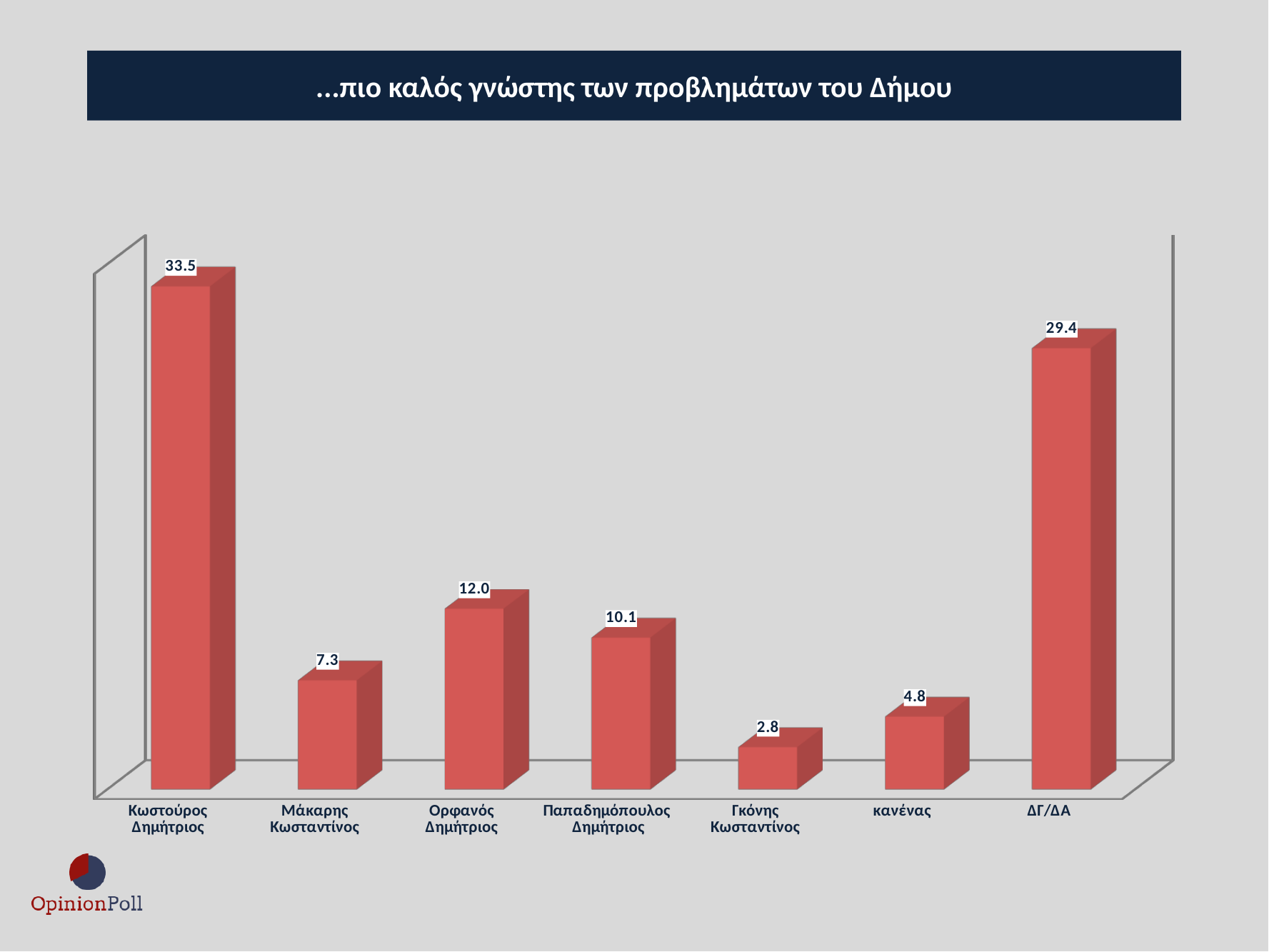
What is the value for Κωστούρος Δημήτριος? 33.5 What kind of chart is this? bar chart What is the title of the chart? ...πιο καλός γνώστης των προβλημάτων του Δήμου What is the value for Μάκαρης Κωσταντίνος? 7.3 What is the value for Παπαδημόπουλος Δημήτριος? 10.1 Which is larger, the value for Ορφανός Δημήτριος or the value for Παπαδημόπουλος Δημήτριος? Ορφανός Δημήτριος Which category has the lowest value? Γκόνης Κωσταντίνος Which category has the highest value? Κωστούρος Δημήτριος What is the value for Ορφανός Δημήτριος? 12.0 How many categories are shown on the x axis? 7 What is the value for ΔΓ/ΔΑ? 29.4 What is the difference between the values for Κωστούρος Δημήτριος and ΔΓ/ΔΑ? 4.1